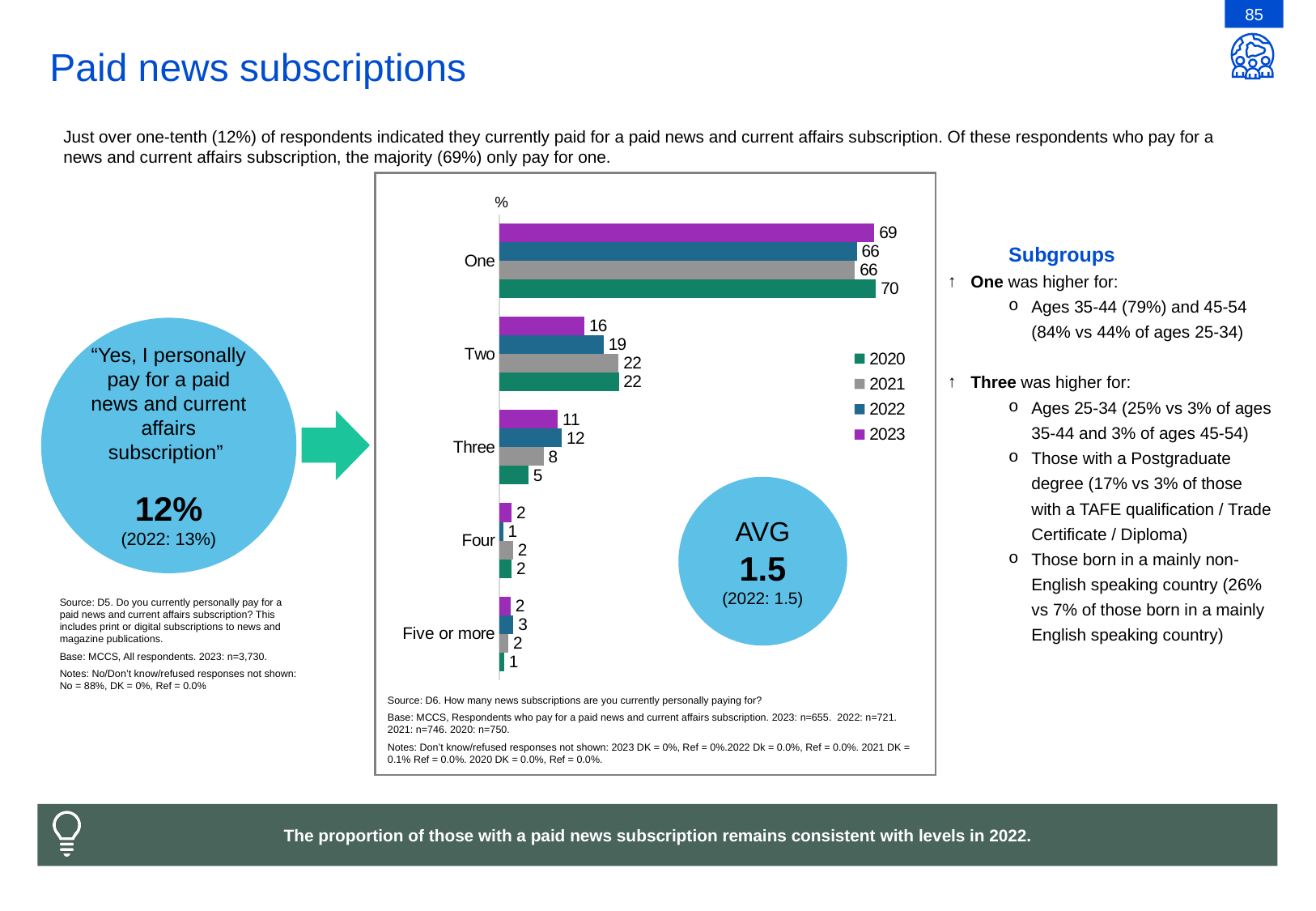
How many series does the chart legend list? 4 Which category has the highest value for the 2023 series? One What is the 2020 value for the 'Two' category? 22 What type of chart is used to show the number of news subscriptions? Bar chart Which colour represents the 2023 series in the chart? Purple How many categories are shown on the x-axis of the chart? 5 What is the 2021 value for 'Five or more'? 2 What percentage of respondents paid for one news subscription in 2023? 69 Which year has the lowest value for the 'Three' category? 2020 What is the difference between the 2020 and 2023 values for the 'Two' category? 6 What is the 2022 value for the 'Three' category? 12 Is the 2023 value for 'Three' larger or smaller than the 2021 value for 'Three'? larger